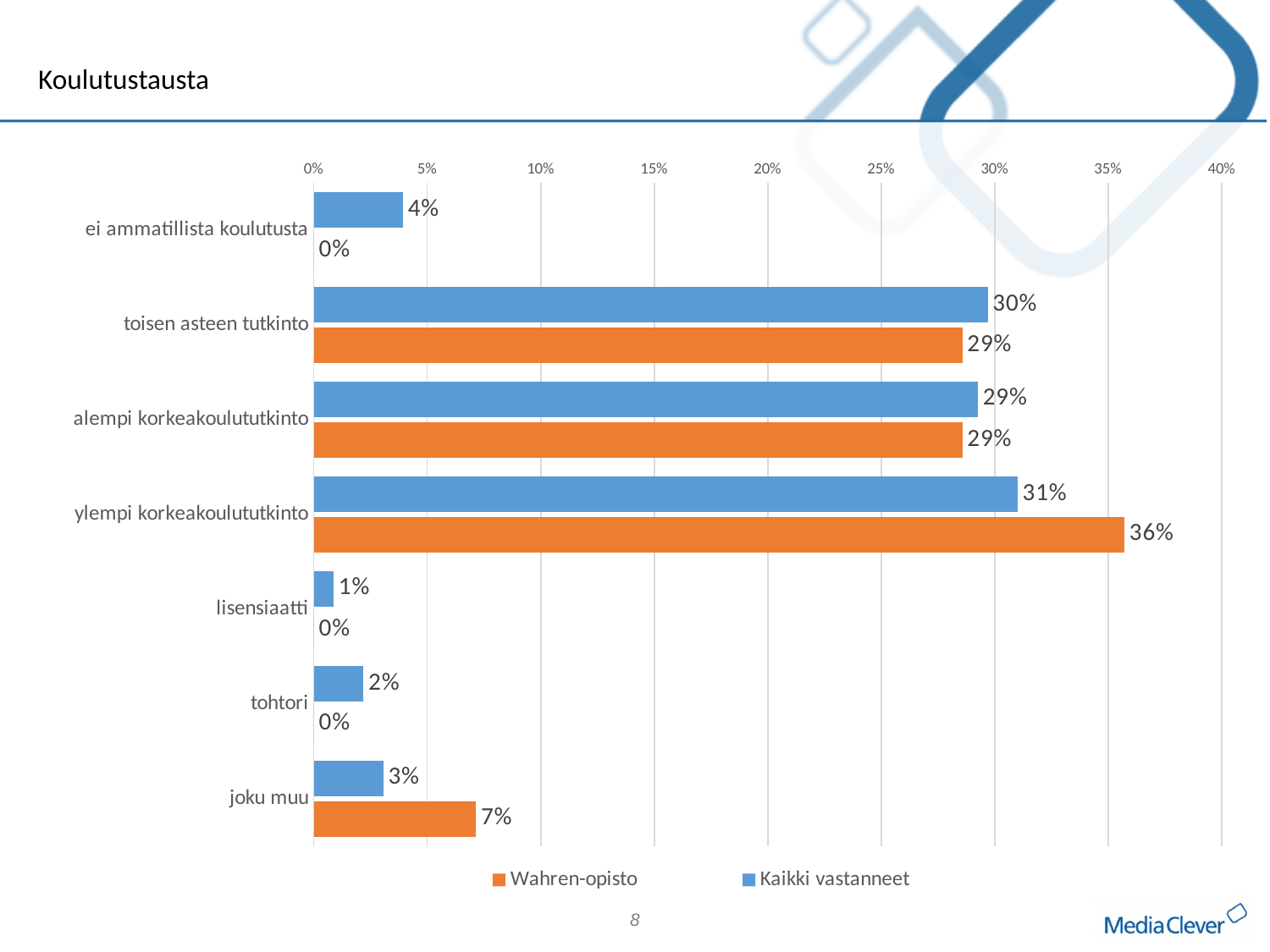
How many series does the legend list? 2 Which category has the highest value for Wahren-opisto? ylempi korkeakoulututkinto How many categories are shown on the chart? 7 Which series has the larger value for joku muu, Wahren-opisto or Kaikki vastanneet? Wahren-opisto What is the value for Kaikki vastanneet in the toisen asteen tutkinto category? 30% What is the value for Kaikki vastanneet in the tohtori category? 2% Which category has the lowest value for Kaikki vastanneet? lisensiaatti What is the value for Wahren-opisto in the ylempi korkeakoulututkinto category? 36% What is the difference between the Wahren-opisto and Kaikki vastanneet values for ylempi korkeakoulututkinto? 5% What colour represents the Wahren-opisto series? orange What is the value for Wahren-opisto in the joku muu category? 7% What kind of chart is shown on the slide? bar chart